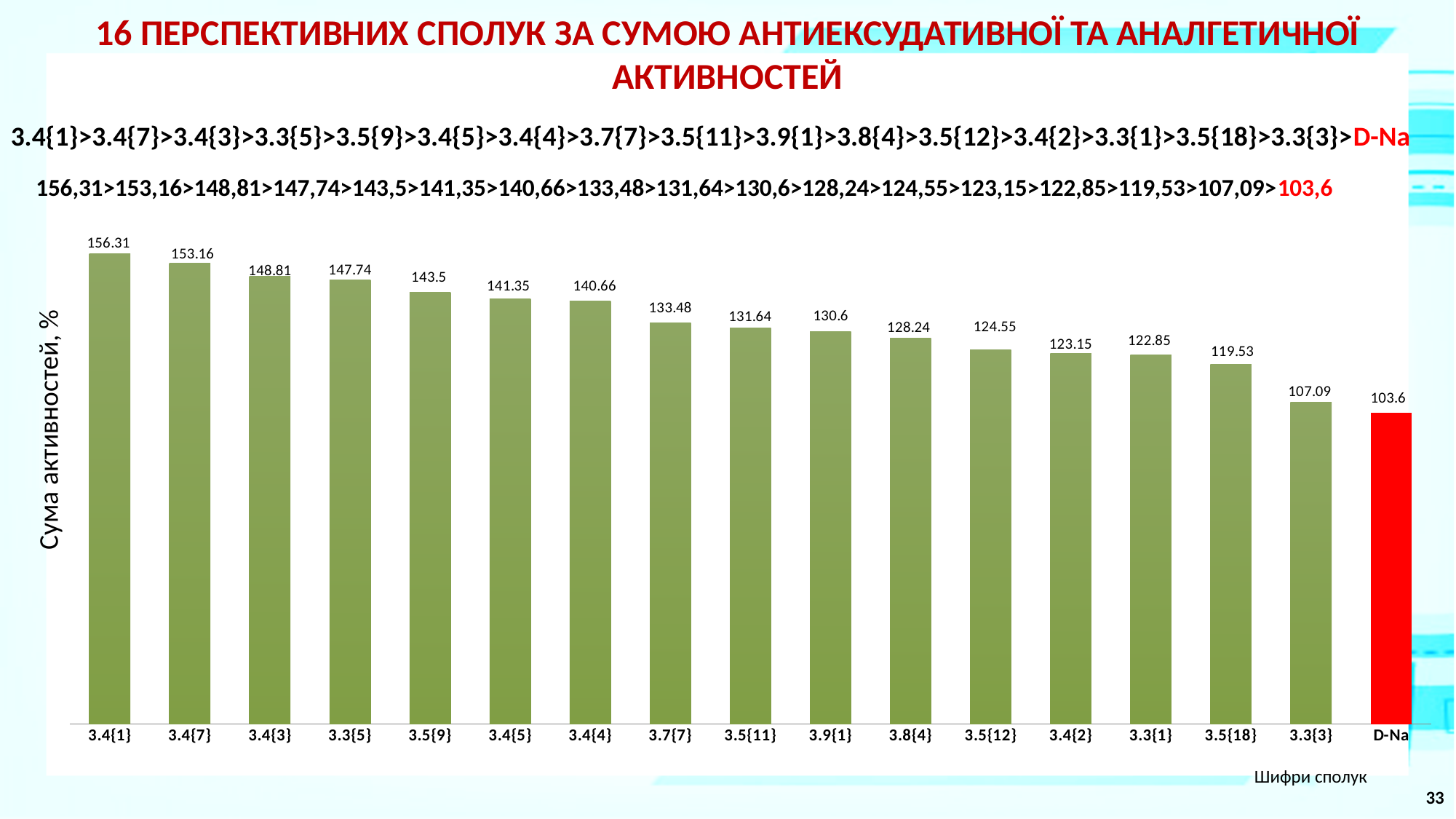
Do the values rise or fall from left to right along the x axis? fall What is the value for 3.5{18}? 119.53 What type of chart is shown on the slide? bar chart What is the difference between the values for 3.4{7} and 3.4{3}? 4.35 Which category has the lowest value? D-Na What is the difference between the values for 3.4{1} and D-Na? 52.71 What is the value for 3.4{1}? 156.31 What is the value for 3.7{7}? 133.48 How many bars are plotted in the chart? 17 What is the value for D-Na? 103.6 Which category has the highest value? 3.4{1} Which is larger, the value for 3.9{1} or the value for 3.5{12}? 3.9{1}